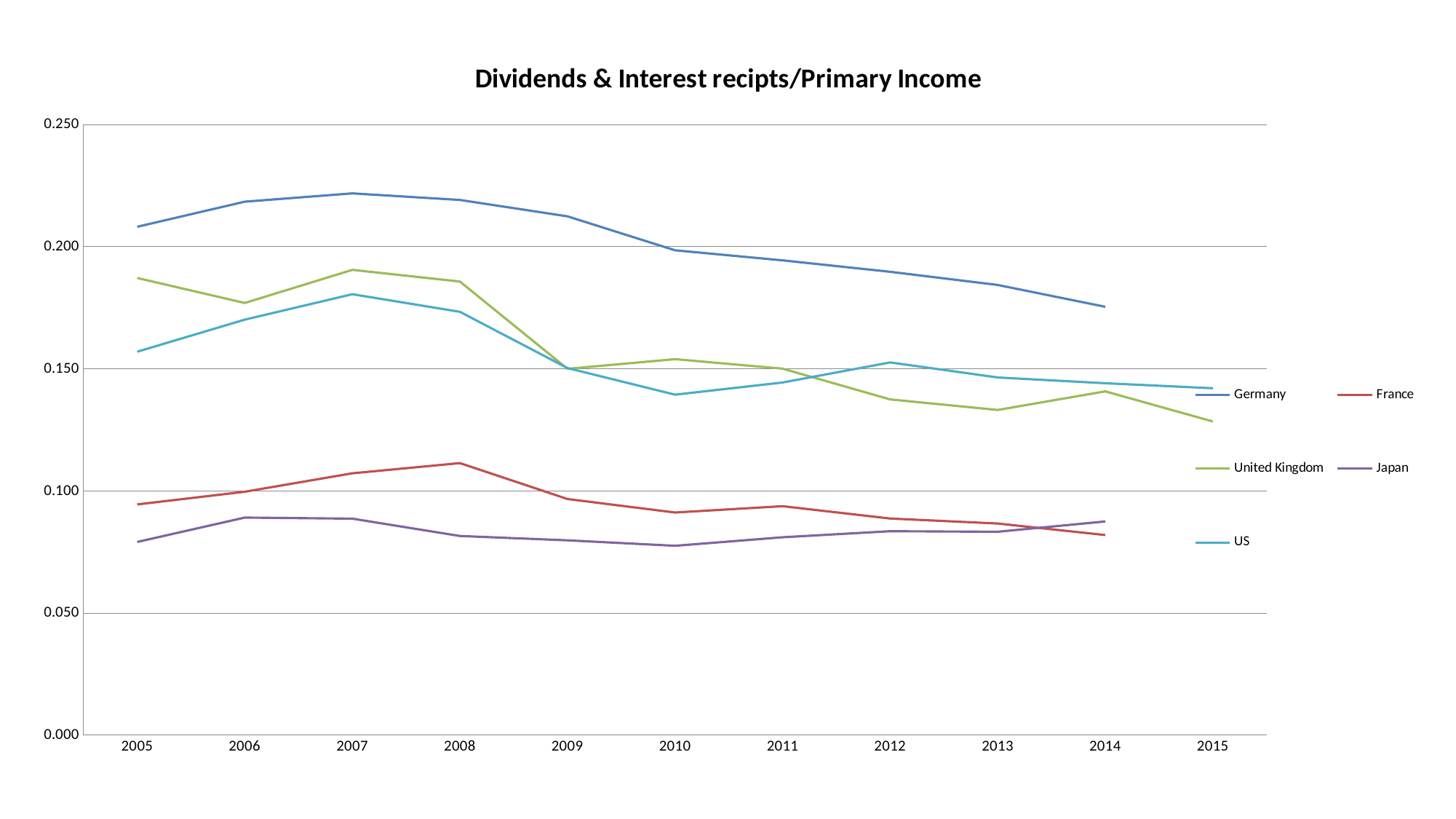
How many series does the legend list? 5 Is the value for Germany in 2014 greater or less than 0.200? less Which series has the highest value in 2005? Germany Is the value for the United Kingdom in 2015 greater or less than 0.150? less Does the Germany line rise or fall from 2007 to 2014? fall What is the title of the chart? Dividends & Interest recipts/Primary Income In 2012, which is larger, the value for the United Kingdom or the value for the US? US What kind of chart is shown on the slide? line chart How many years are shown on the x axis? 11 Is the value for Germany in 2005 greater or less than 0.200? greater Which series has the lowest value in 2010? Japan